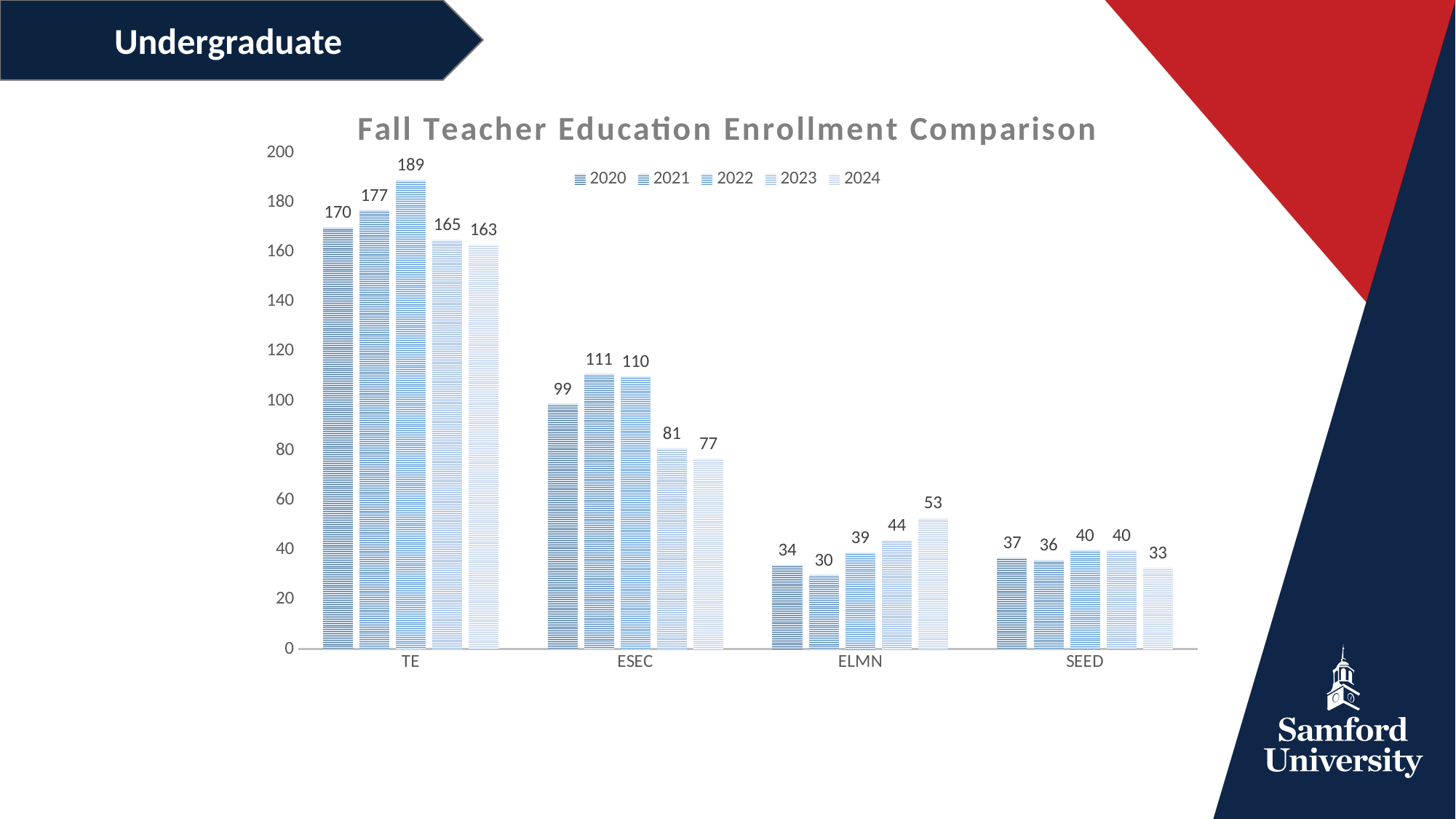
What is the difference between the 2022 and 2024 values for TE? 26 What is the 2021 value for ELMN? 30 What is the 2024 value for ESEC? 77 Do the values for ELMN rise or fall from 2021 to 2024? rise What is the title of the chart? Fall Teacher Education Enrollment Comparison How many categories are shown on the x axis? 4 Which year has the lowest value for SEED? 2024 Which year has the highest value for ELMN? 2024 What is the 2022 value for TE? 189 What kind of chart is shown? bar chart Which is larger, the 2020 value for ESEC or the 2023 value for ESEC? 2020 How many series does the legend list? 5